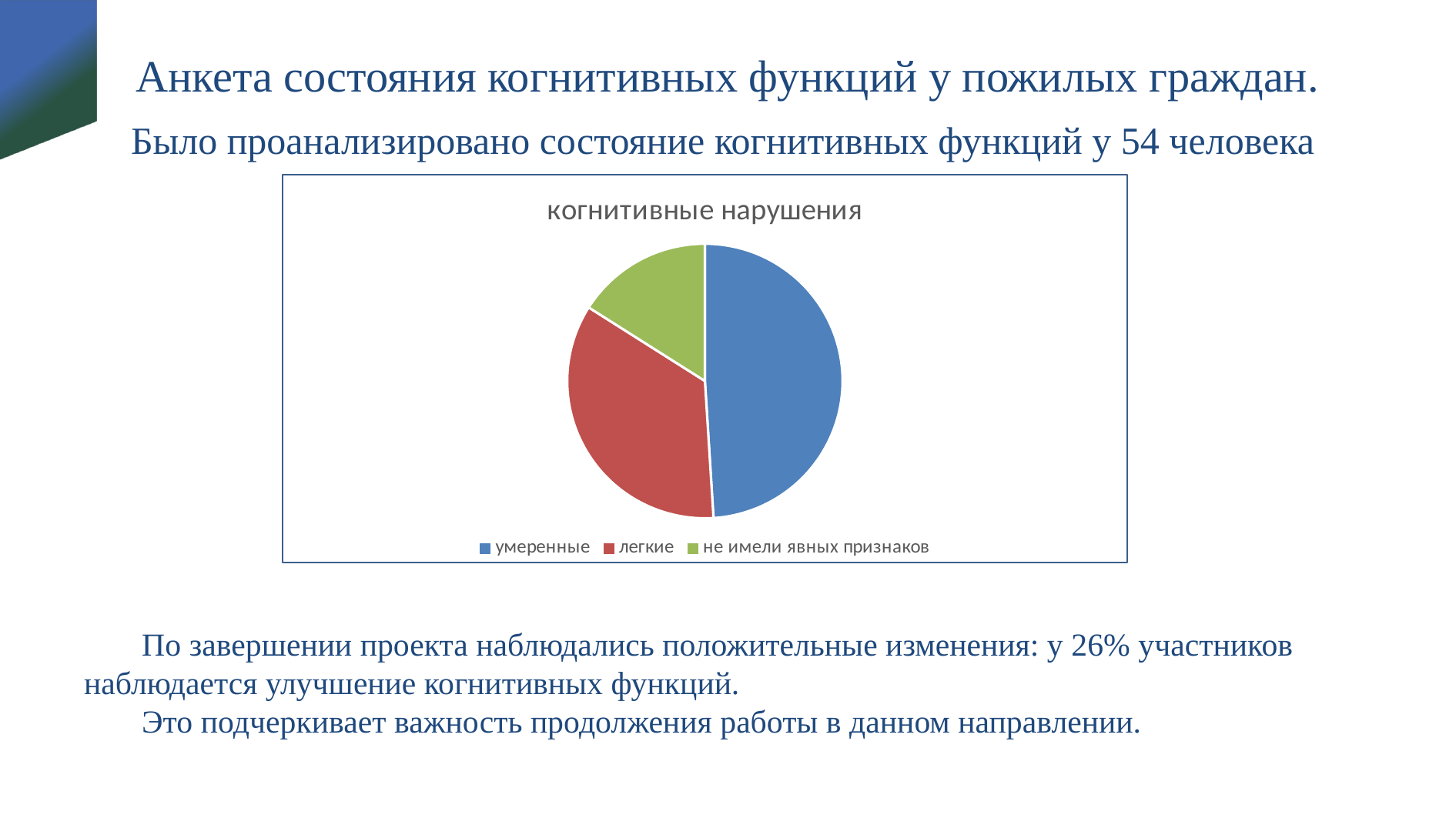
Which category has the largest slice of the pie? умеренные How many entries does the chart legend list? 3 Which slice is larger, легкие or не имели явных признаков? легкие Which slice is smaller, умеренные or не имели явных признаков? не имели явных признаков What kind of chart is shown on the slide? pie chart What is the title of the chart? когнитивные нарушения How many slices does the pie chart have? 3 Which category has the smallest slice of the pie? не имели явных признаков What colour is the slice for умеренные? blue Which slice is larger, умеренные or легкие? умеренные